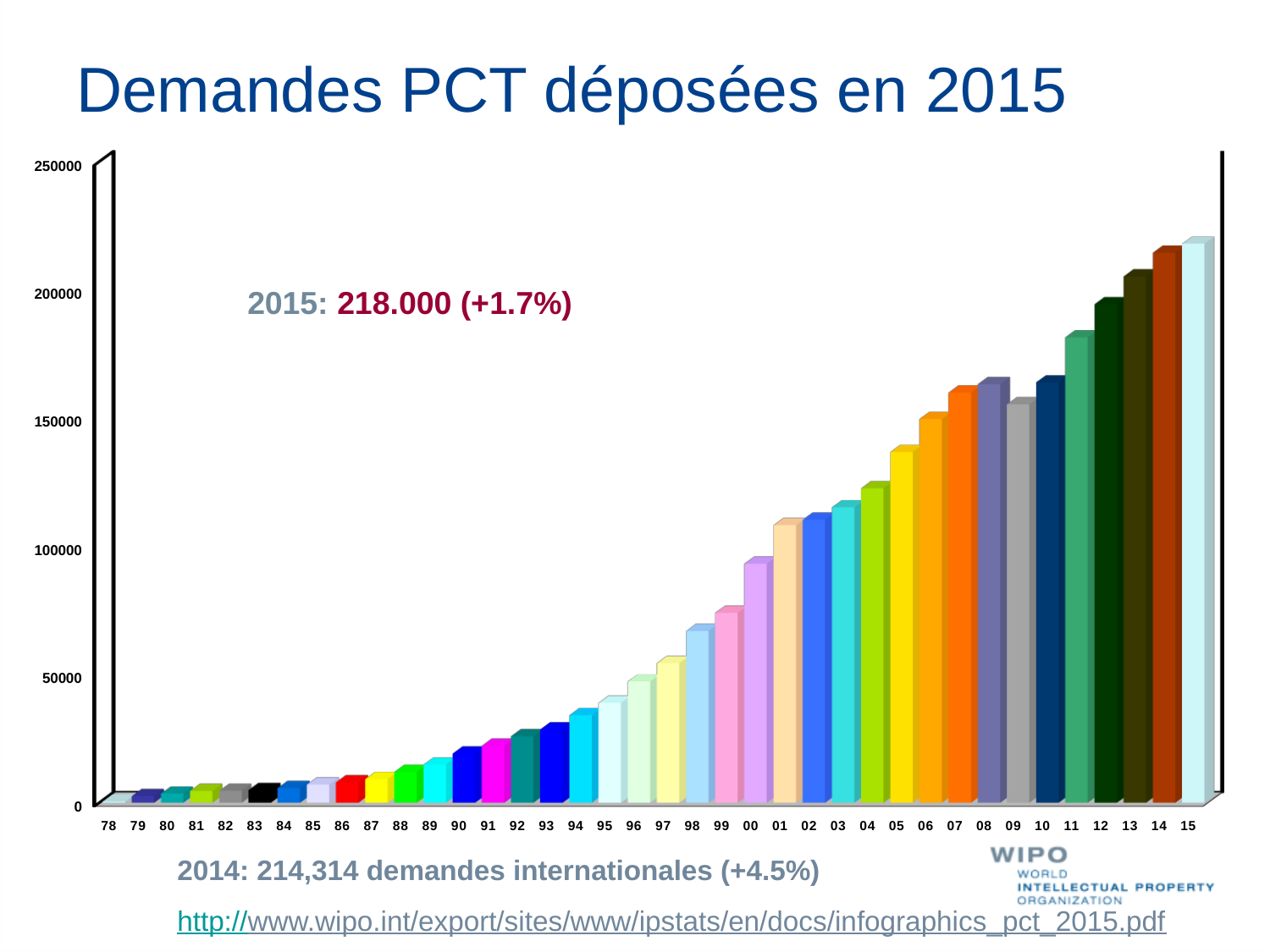
How many years (bars) are plotted on the chart? 38 Which year has the highest number of PCT applications? 15 Which year has the lowest number of PCT applications? 78 Is the value for 00 greater or less than 100000? less Do the values generally rise or fall from 78 to 15? rise What percentage growth is given for 2015? +1.7% Is the value for 10 greater or less than 150000? greater What kind of chart is shown on the slide? bar chart What is the title of the slide's chart? Demandes PCT déposées en 2015 Which year has the larger value, 08 or 09? 08 According to the slide, how many international applications were filed in 2014? 214,314 According to the slide, how many PCT applications were filed in 2015? 218.000